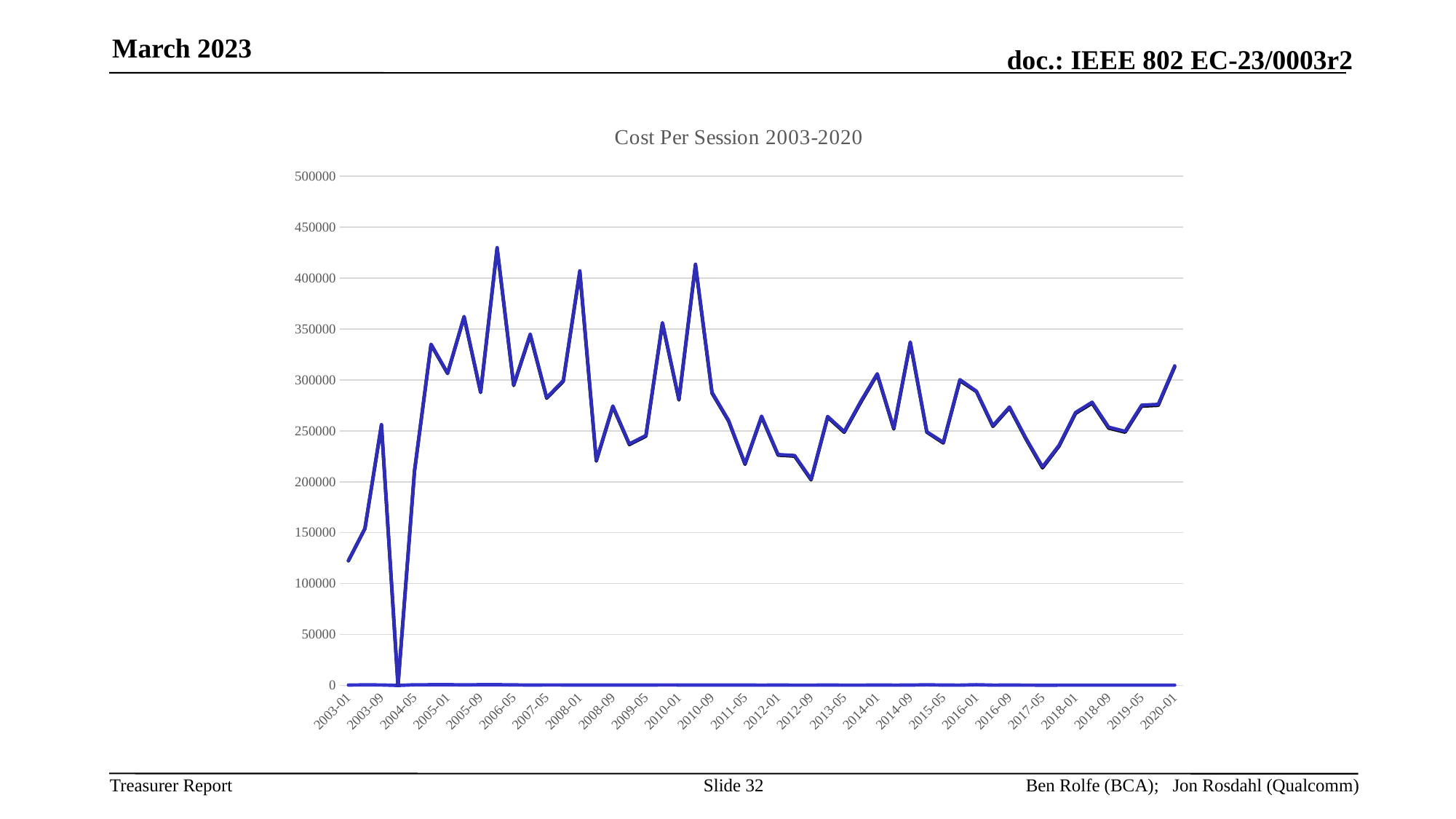
Which is larger, the value for 2008-01 or the value for 2008-09? 2008-01 What is the title of the chart? Cost Per Session 2003-2020 Is the value for 2004-05 greater or less than 50000? greater Which of the labeled dates on the x axis has the lowest value? 2003-01 Is the value for 2008-01 greater or less than 350000? greater Is the value for 2003-01 greater or less than 150000? less What kind of chart is shown on the slide? line chart Does the value rise or fall from 2017-05 to 2020-01? rise Which is larger, the value for 2003-01 or the value for 2003-09? 2003-09